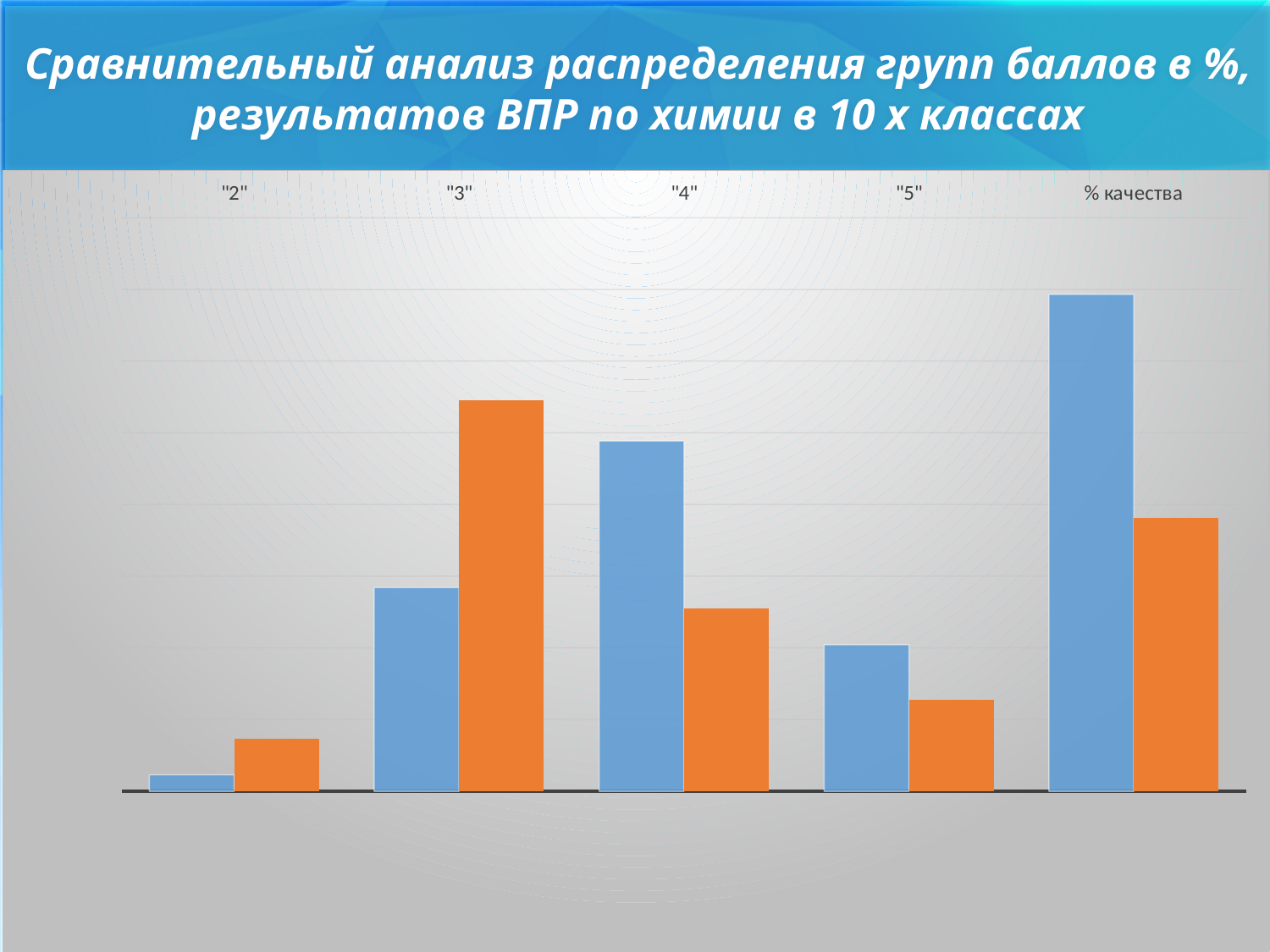
What is the title of the slide containing the chart? Сравнительный анализ распределения групп баллов в %, результатов ВПР по химии в 10 х классах Which category has the shortest orange bar? "2" How many categories are shown along the x axis of the chart? 5 In the "2" category, which bar is taller, the blue one or the orange one? orange Which category has the shortest blue bar? "2" What two colours are used for the bars in the chart? blue and orange Which category has the tallest blue bar? % качества In the "3" category, which bar is taller, the blue one or the orange one? orange In the "4" category, which bar is taller, the blue one or the orange one? blue Which category has the tallest orange bar? "3" What kind of chart is shown on the slide? bar chart